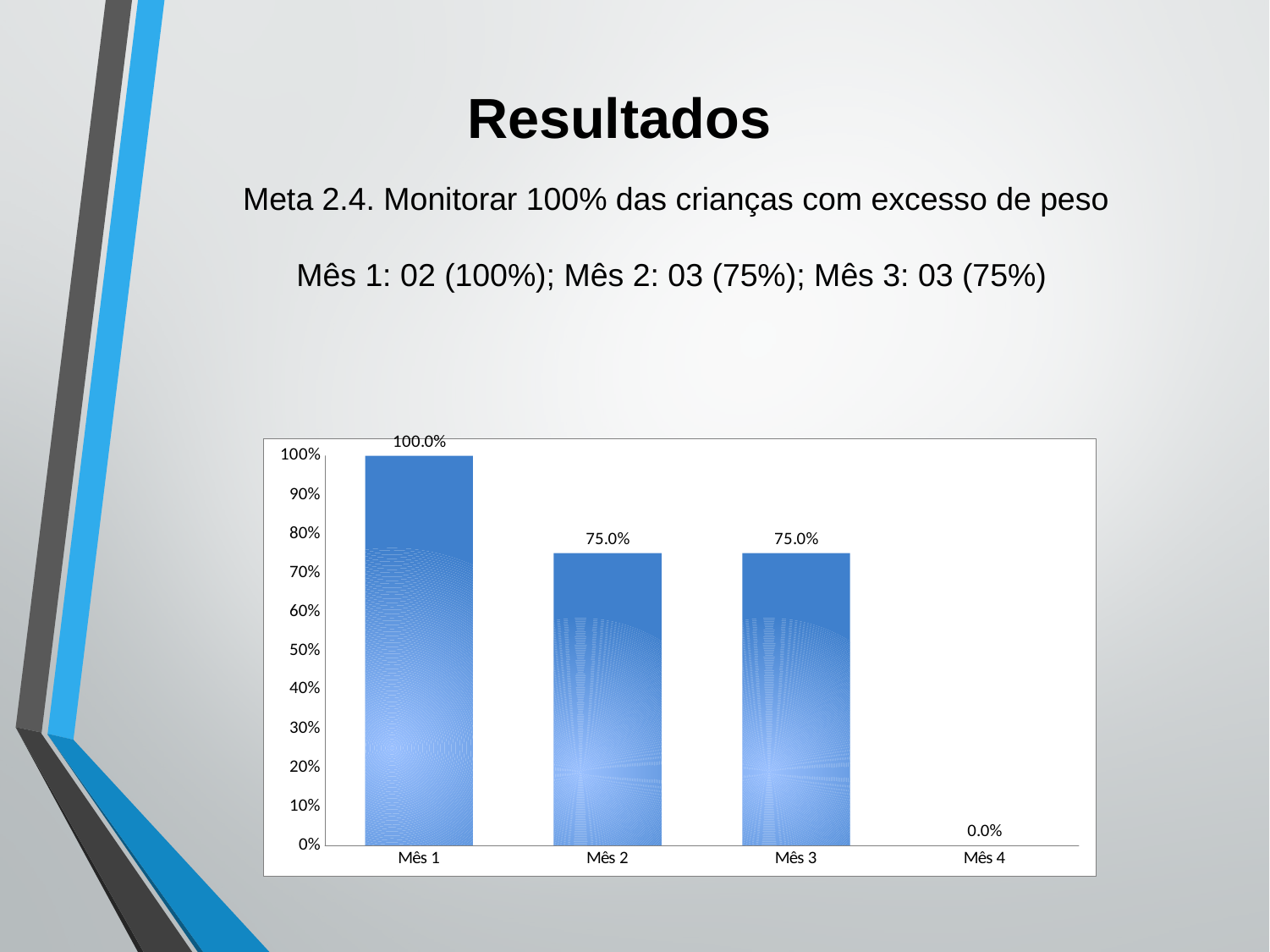
Do the values rise or fall from Mês 1 to Mês 4? fall Which category has the highest value? Mês 1 What is the value for Mês 1? 100.0% What is the label of the category with the value 0.0%? Mês 4 Which category has the lowest value? Mês 4 What is the value for Mês 4? 0.0% Which is larger, the value for Mês 1 or the value for Mês 2? Mês 1 What is the value for Mês 2? 75.0% Is the value for Mês 3 greater or less than 50%? greater How many categories are shown on the x axis? 4 What kind of chart is shown on the slide? bar chart What is the difference between the values for Mês 1 and Mês 3? 25.0%